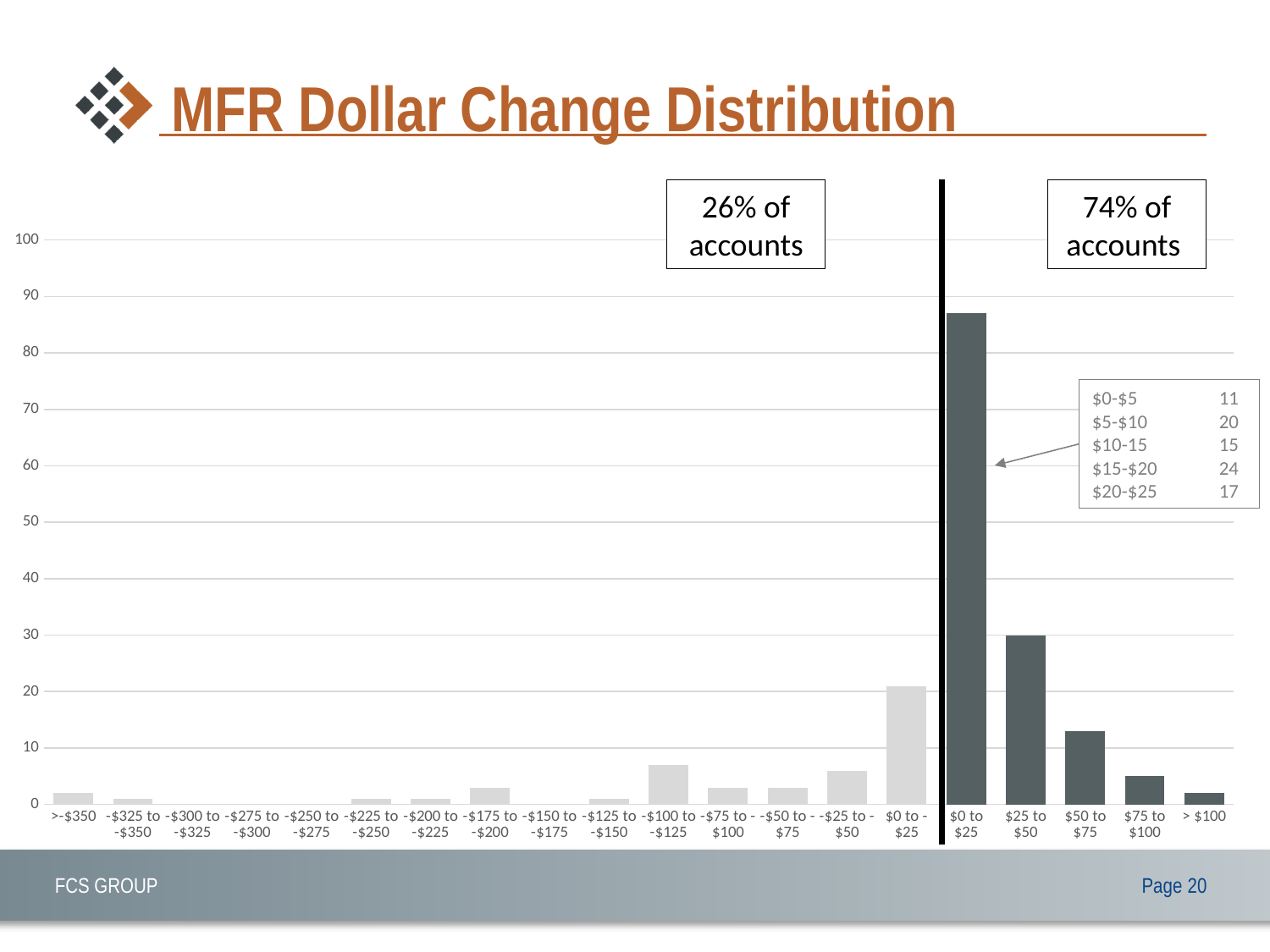
In the callout box breaking down the $0 to $25 bar, which range has the highest value? $15-$20 In the callout box breaking down the $0 to $25 bar, what is the value for $5-$10? 20 According to the text box on the right side of the chart, what share of accounts falls to the right of the vertical black line? 74% of accounts Is the value for the $0 to $25 category greater or less than 80? greater Is the value for the $25 to $50 category greater or less than 20? greater What kind of chart is shown on the slide? bar chart Which is larger, the value for $50 to $75 or the value for $75 to $100? $50 to $75 Which category has the highest bar in the chart? $0 to $25 How many categories are shown along the x axis of the chart? 20 In the callout box breaking down the $0 to $25 bar, what is the value for $15-$20? 24 Which is larger, the value for $0 to -$25 or the value for $25 to $50? $25 to $50 Is the value for the $0 to -$25 category greater or less than 30? less